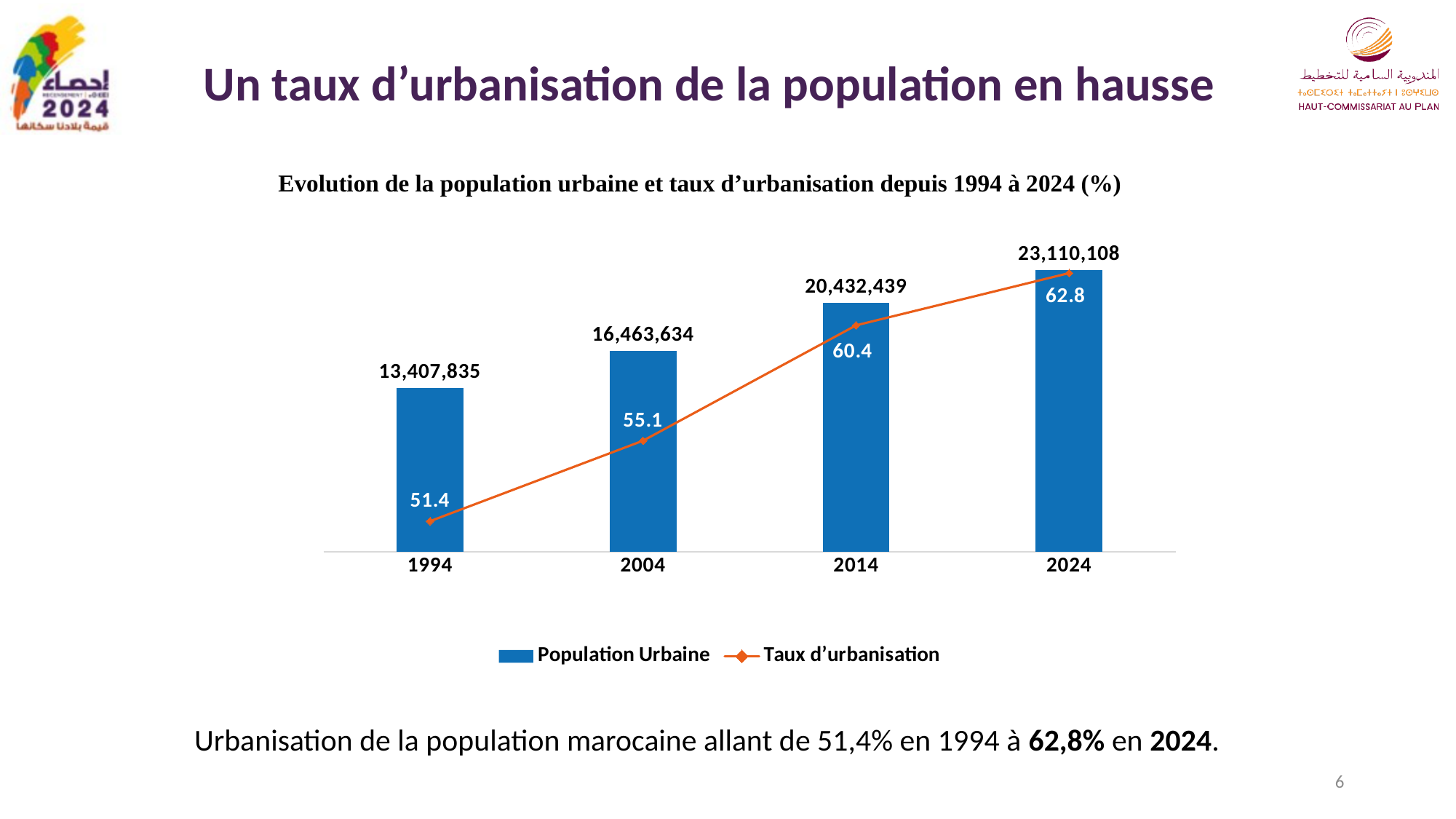
What is the Taux d'urbanisation value for 1994? 51.4 Which year has the lowest Taux d'urbanisation? 1994 Does the Taux d'urbanisation rise or fall from 1994 to 2024? rise How many series does the legend list? 2 How many years are shown on the x axis? 4 What is the Taux d'urbanisation value for 2014? 60.4 What is the Population Urbaine value for 2024? 23,110,108 What is the Population Urbaine value for 2004? 16,463,634 Which is larger, the Population Urbaine in 1994 or in 2014? 2014 Which year has the highest Population Urbaine? 2024 What is the difference in Taux d'urbanisation between 2024 and 1994? 11.4 What is the difference in Population Urbaine between 2014 and 2004? 3,968,805